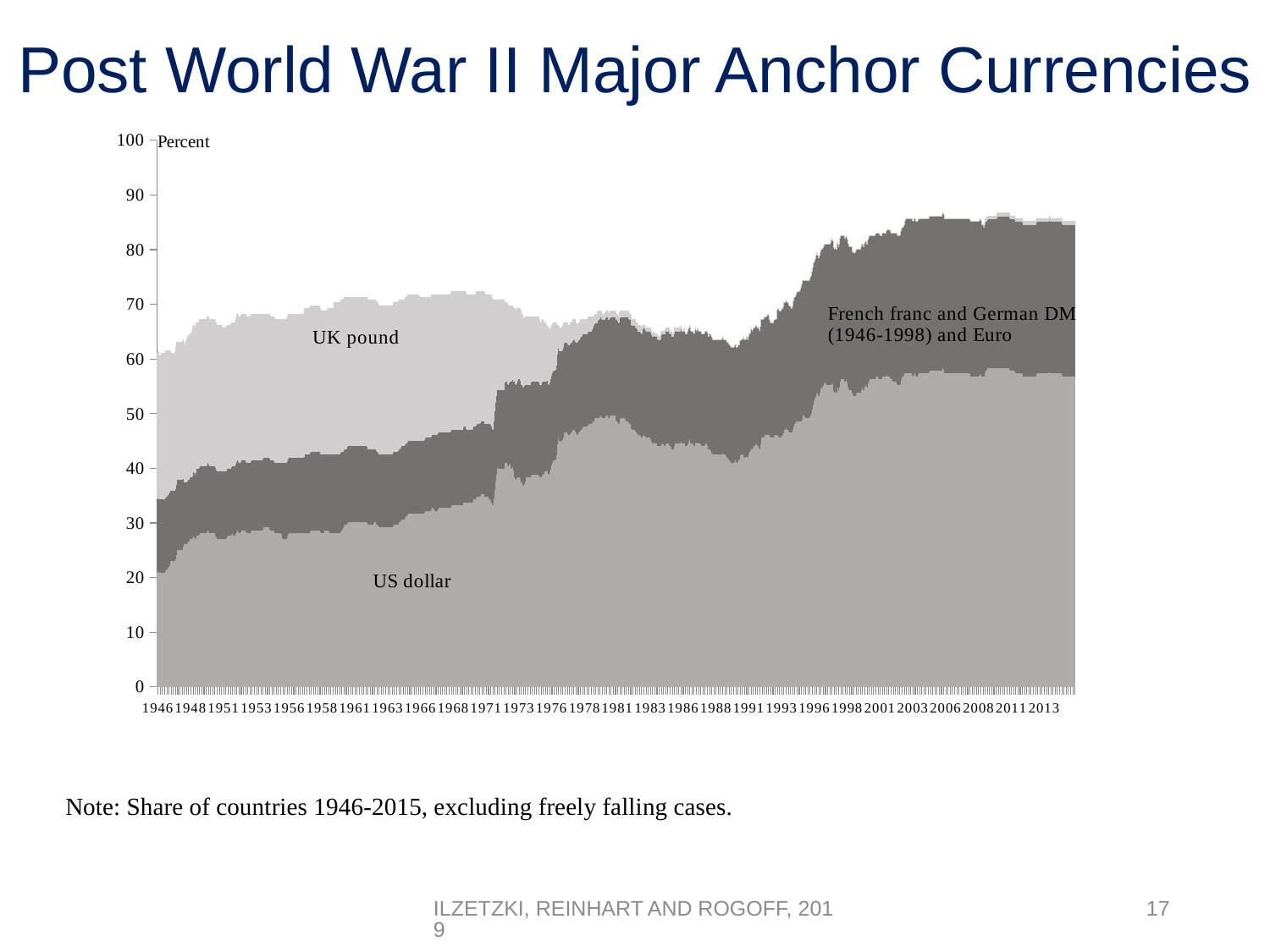
Does the share of the US dollar rise or fall overall from 1946 to 2013? rise Which currency has the larger share in 2013, the US dollar or the French franc/German DM and Euro? US dollar What kind of chart is shown on the slide? Stacked area chart Is the combined share of all three anchor currencies in 1988 greater or less than 70? less What unit label is shown at the top of the vertical axis? Percent How many currency series are plotted in the chart? 3 Is the combined share of all three anchor currencies in 1946 greater or less than 50? greater Is the combined share of all three anchor currencies in 2013 greater or less than 80? greater Which currency series is plotted at the bottom of the stack? US dollar What is the title of the slide containing the chart? Post World War II Major Anchor Currencies